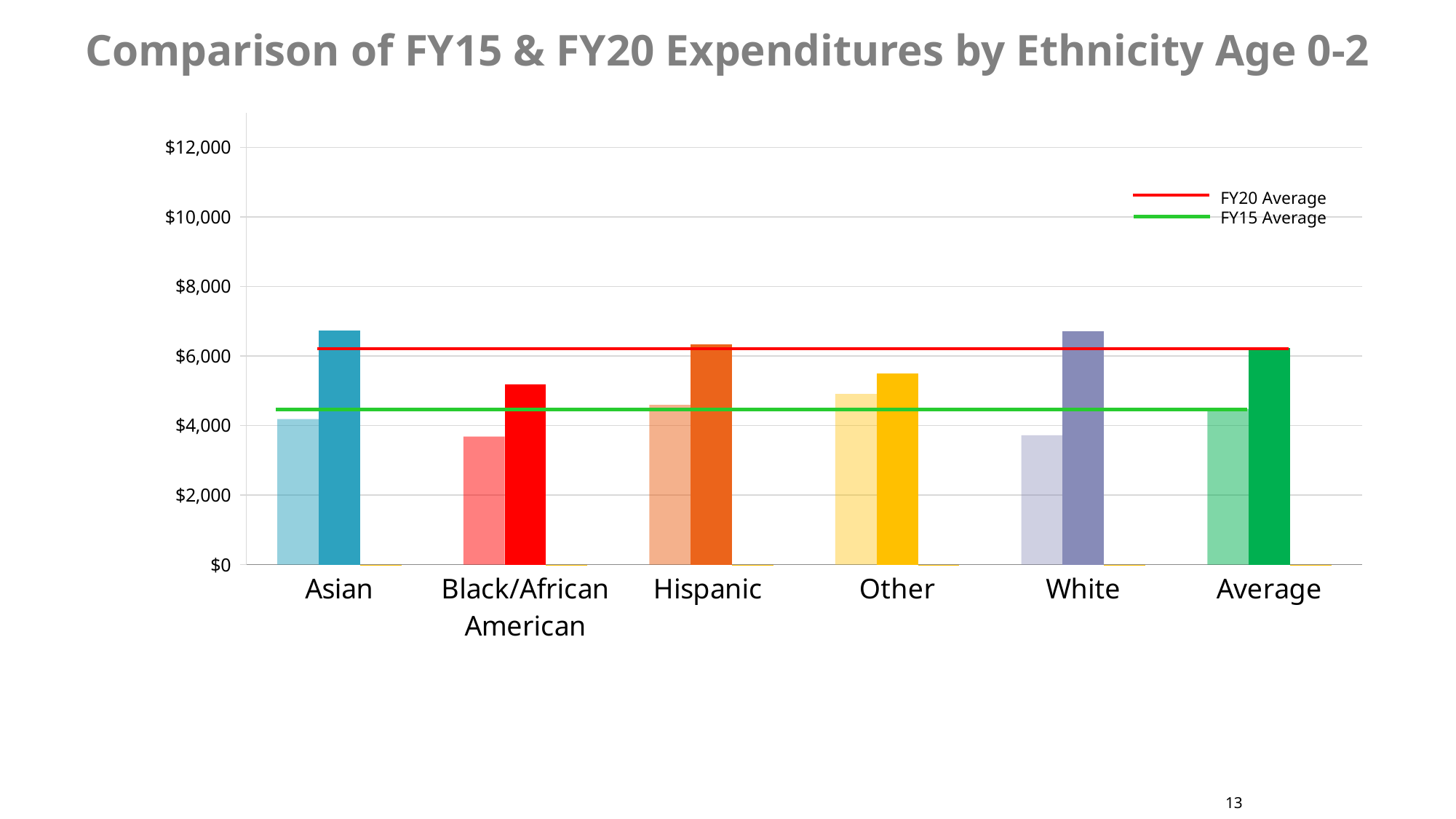
Is the value of the darker (right) bar for Other greater or less than $6,000? less How many categories are shown along the x axis? 6 Is the value of the darker (right) bar for Hispanic greater or less than $6,000? greater Which category has the highest lighter (left) bar? Other Is the value of the darker (right) bar for Asian greater or less than $6,000? greater What kind of chart is shown on the slide? bar chart What is the title of the chart? Comparison of FY15 & FY20 Expenditures by Ethnicity Age 0-2 Which two entries are listed in the legend? FY20 Average and FY15 Average Which is larger, the darker (right) bar for Asian or the darker (right) bar for Black/African American? Asian How many entries does the legend list? 2